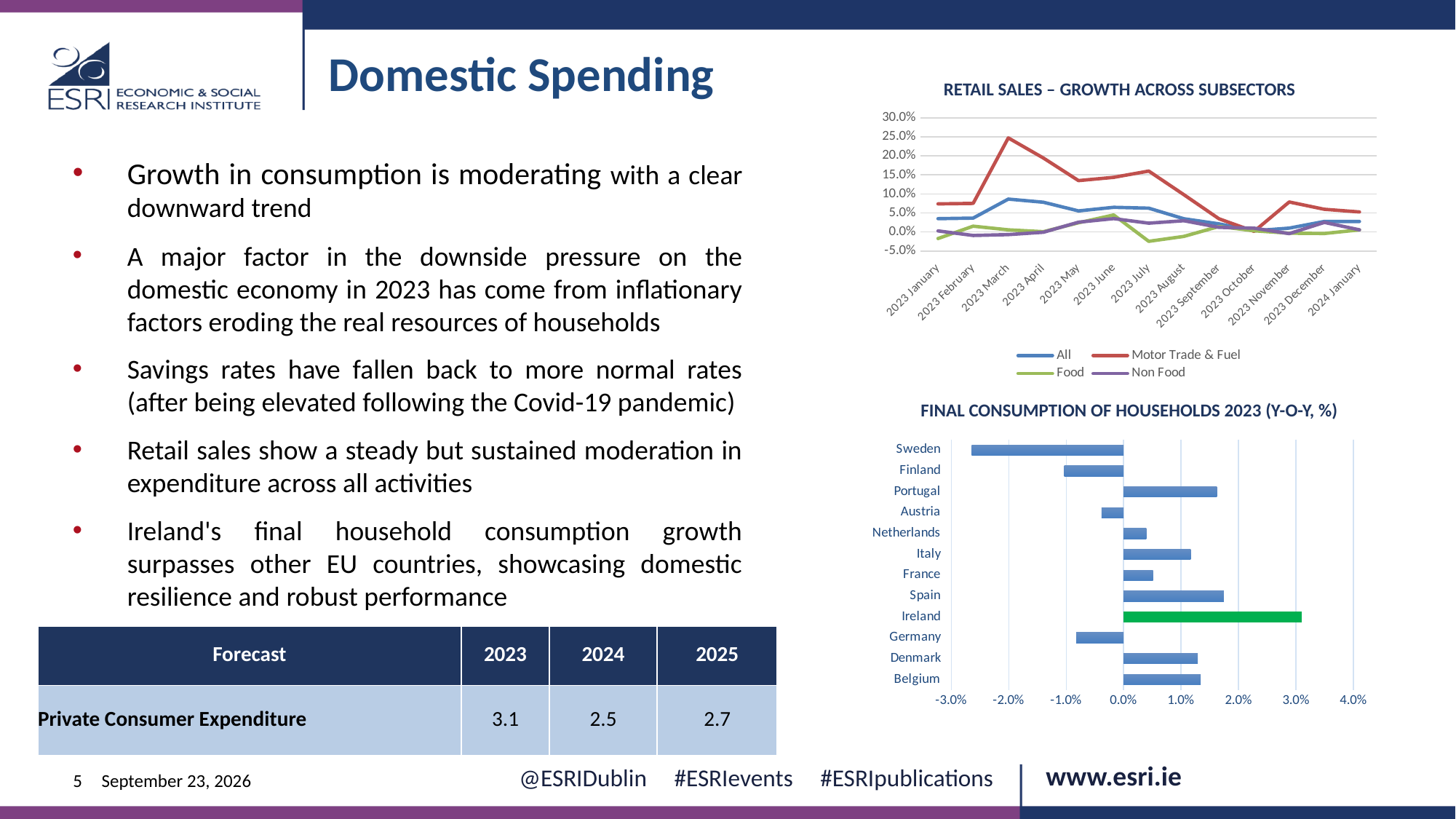
In the 'RETAIL SALES – GROWTH ACROSS SUBSECTORS' chart, how many months are shown on the x axis? 13 How many series does the legend of the 'RETAIL SALES – GROWTH ACROSS SUBSECTORS' chart list? 4 In the 'FINAL CONSUMPTION OF HOUSEHOLDS 2023 (Y-O-Y, %)' chart, is the value for Sweden greater or less than -2.0%? less In the 'RETAIL SALES – GROWTH ACROSS SUBSECTORS' chart, which series has the highest value in 2023 March? Motor Trade & Fuel In the 'FINAL CONSUMPTION OF HOUSEHOLDS 2023 (Y-O-Y, %)' chart, which is larger, the value for Spain or the value for Netherlands? Spain How many countries are shown in the 'FINAL CONSUMPTION OF HOUSEHOLDS 2023 (Y-O-Y, %)' chart? 12 In the 'RETAIL SALES – GROWTH ACROSS SUBSECTORS' chart, is the Food value for 2023 July greater or less than 0.0%? less What kind of chart is the 'RETAIL SALES – GROWTH ACROSS SUBSECTORS' chart? Line chart In the 'FINAL CONSUMPTION OF HOUSEHOLDS 2023 (Y-O-Y, %)' chart, which country has the highest value? Ireland In the 'RETAIL SALES – GROWTH ACROSS SUBSECTORS' chart, is the Motor Trade & Fuel value for 2023 March greater or less than 20.0%? greater What kind of chart is the 'FINAL CONSUMPTION OF HOUSEHOLDS 2023 (Y-O-Y, %)' chart? Bar chart In the 'FINAL CONSUMPTION OF HOUSEHOLDS 2023 (Y-O-Y, %)' chart, which country has the lowest value? Sweden